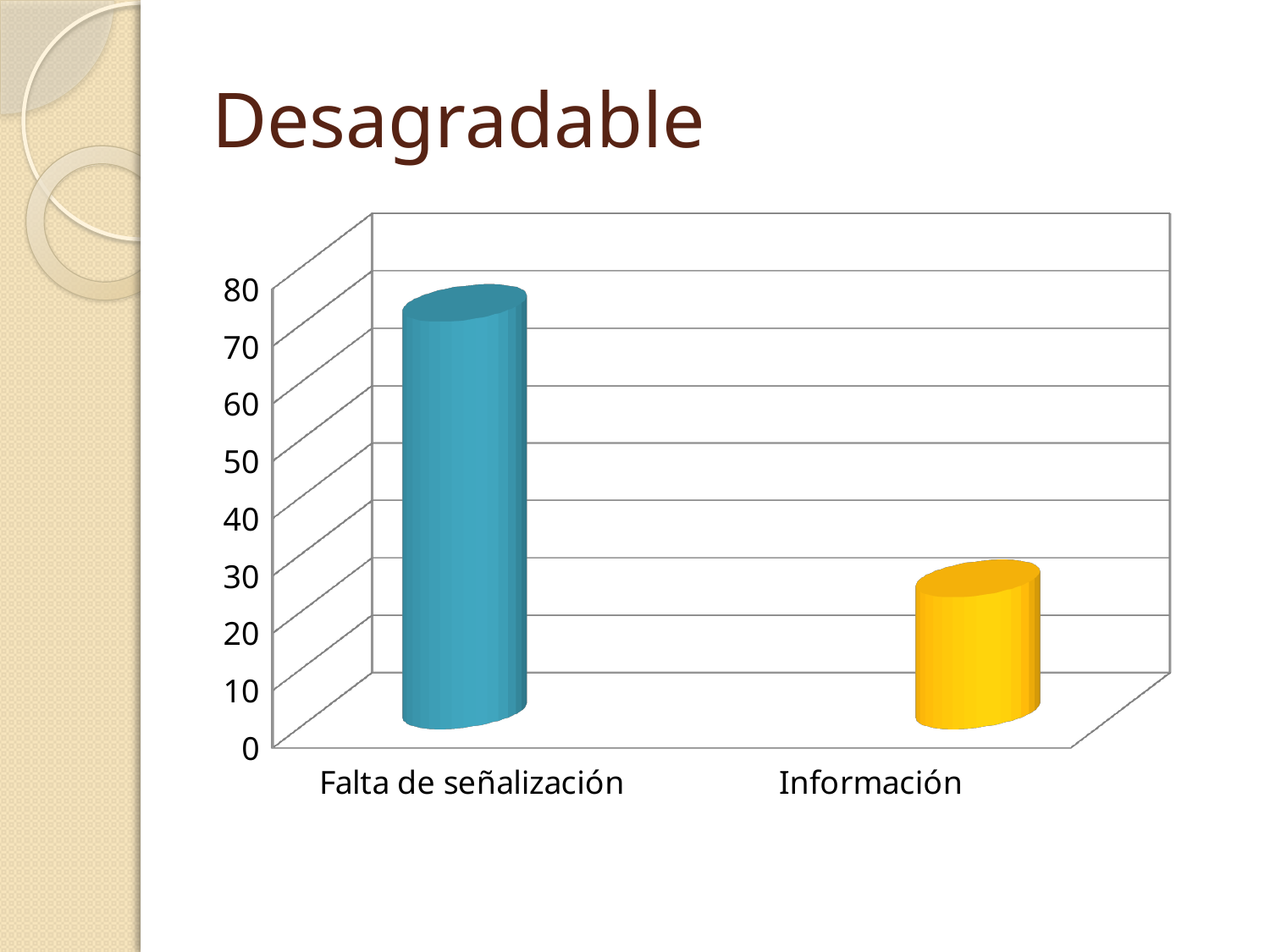
Is the value for Falta de señalización greater or less than 80? less Which category has the highest value? Falta de señalización What kind of chart is shown on the slide? bar chart What is the highest value shown on the vertical axis? 80 Is the value for Información greater or less than 40? less Which is larger, the value for Falta de señalización or the value for Información? Falta de señalización Do the values rise or fall from Falta de señalización to Información along the x axis? fall Which category has the lowest value? Información How many categories are plotted in the chart? 2 What is the title of the slide containing the chart? Desagradable Is the value for Falta de señalización greater or less than 60? greater